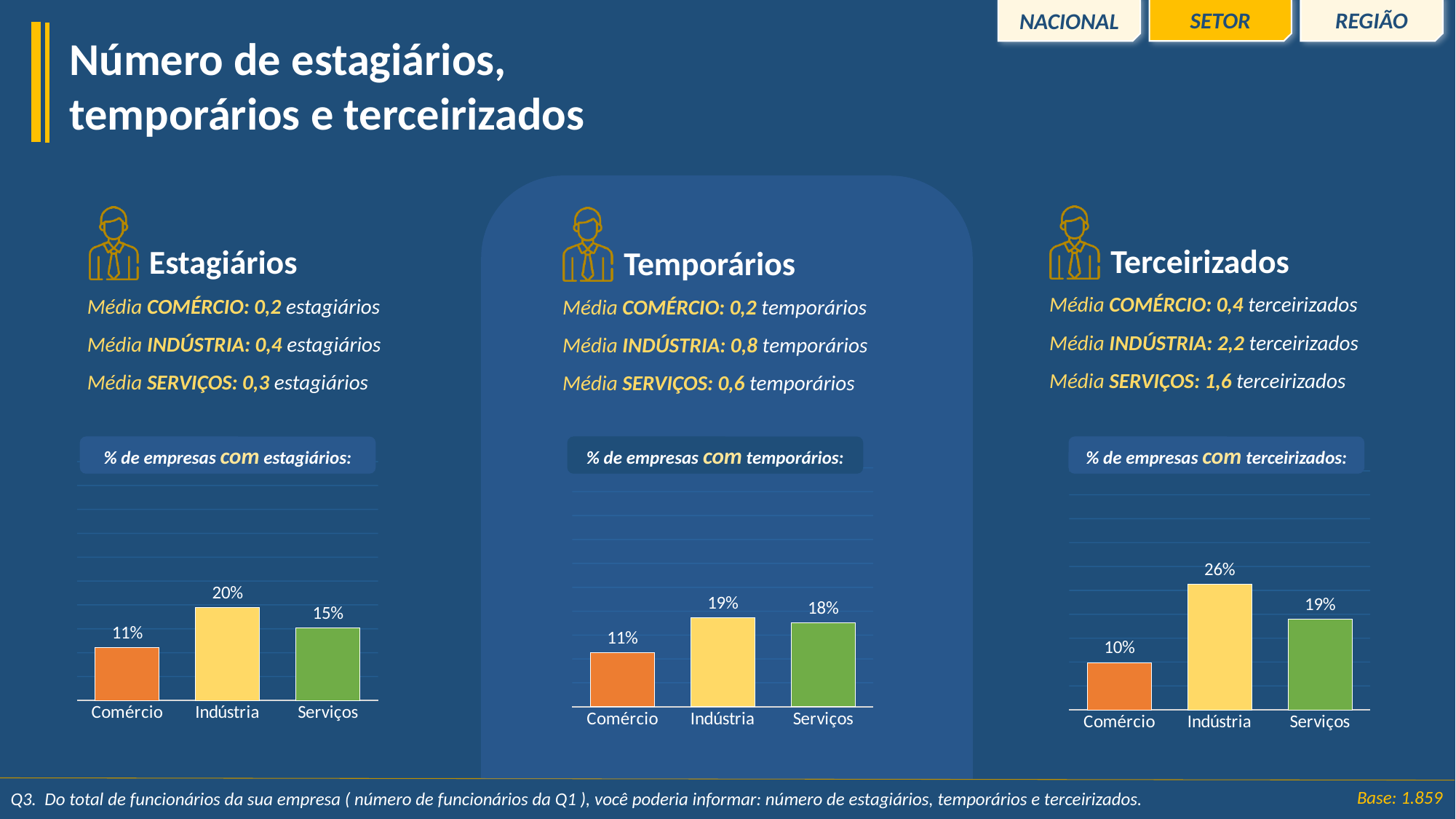
In the '% de empresas com estagiários' chart, which category has the lowest value? Comércio In the '% de empresas com temporários' chart, what is the value for Serviços? 18% How many bar charts are on the slide? 3 In the '% de empresas com terceirizados' chart, what is the value for Comércio? 10% What kind of chart is the '% de empresas com terceirizados' chart? Bar chart In the '% de empresas com terceirizados' chart, what is the difference between Indústria and Comércio? 16% In the '% de empresas com terceirizados' chart, which category has the highest value? Indústria How many categories does the '% de empresas com temporários' chart show? 3 In the '% de empresas com estagiários' chart, which is larger, Indústria or Serviços? Indústria In the '% de empresas com estagiários' chart, what is the value for Indústria? 20% In the '% de empresas com temporários' chart, what colour is the Comércio bar? Orange In the '% de empresas com temporários' chart, what is the difference between Indústria and Comércio? 8%